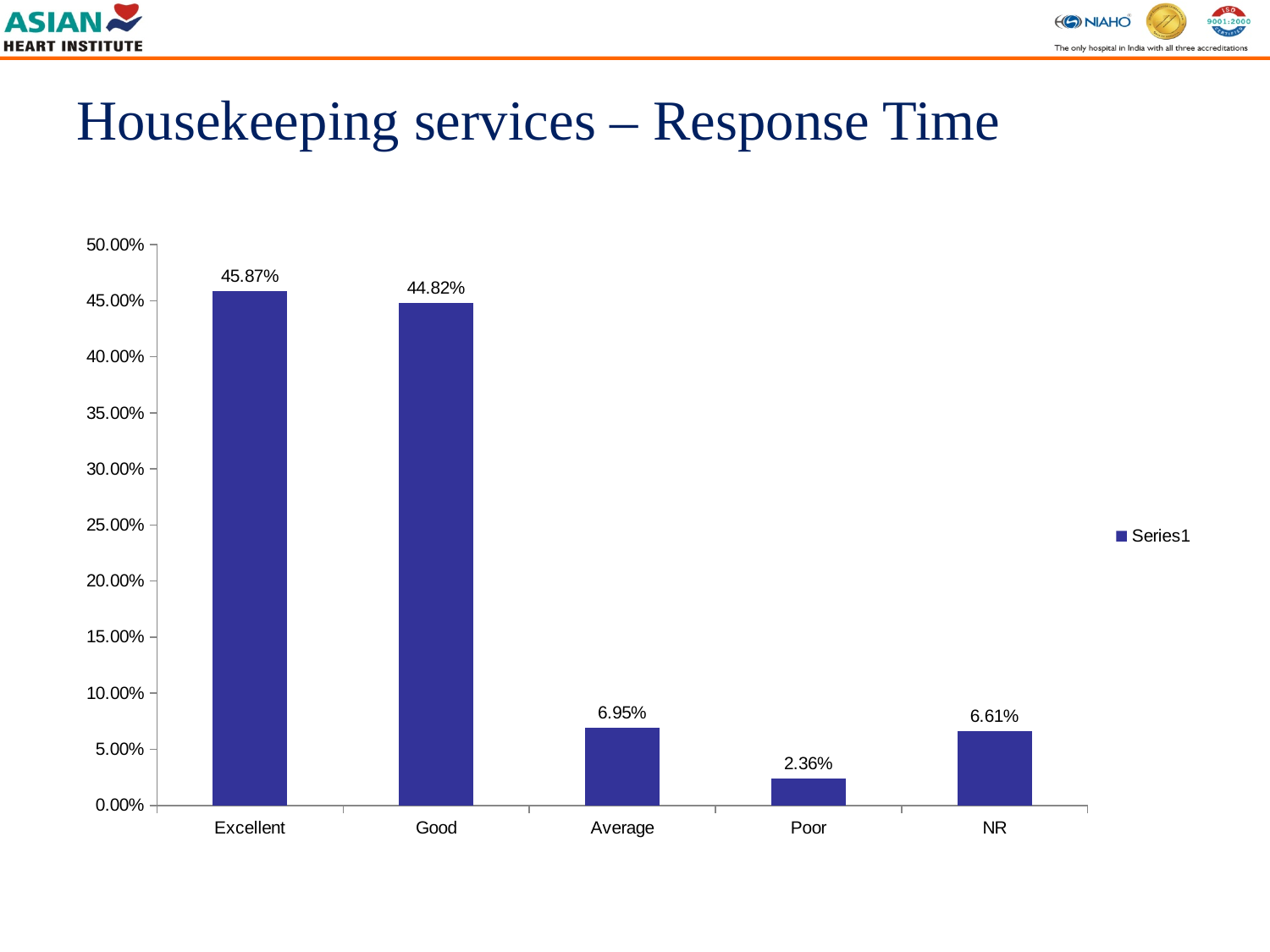
What is the value for Average? 6.95% Which is larger, the value for Average or the value for NR? Average What is the difference between the values for Excellent and Good? 1.05% What is the value for Poor? 2.36% What is the value for Good? 44.82% How many categories are shown on the x axis? 5 Which category has the lowest value? Poor Is the value for Good greater or less than 40.00%? greater What kind of chart is shown on the slide? Bar chart What is the value for Excellent? 45.87% Which category has the highest value? Excellent What is the value for NR? 6.61%